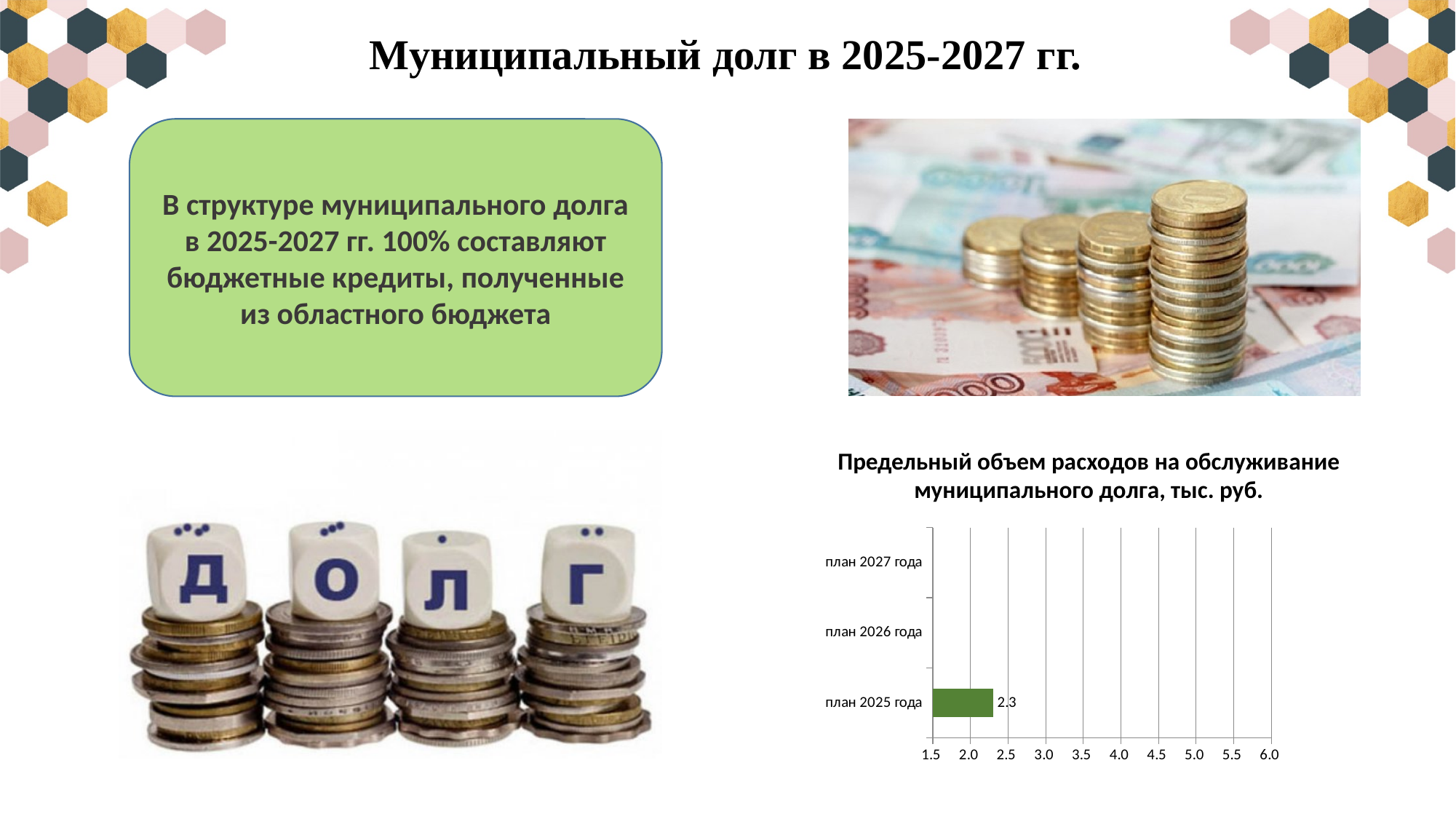
How many categories are listed on the vertical axis of the chart? 3 Which category is the only one with a visible bar in the chart? план 2025 года What is the title of the chart on the slide? Предельный объем расходов на обслуживание муниципального долга, тыс. руб. Which category has the highest value in the chart? план 2025 года What kind of chart is shown under the title 'Предельный объем расходов на обслуживание муниципального долга, тыс. руб.'? bar chart Is the value for план 2025 года greater or less than 2.0? greater What is the highest value shown on the horizontal axis of the chart? 6.0 Is the value for план 2025 года greater or less than 3.0? less What is the value for план 2025 года in the chart 'Предельный объем расходов на обслуживание муниципального долга, тыс. руб.'? 2.3